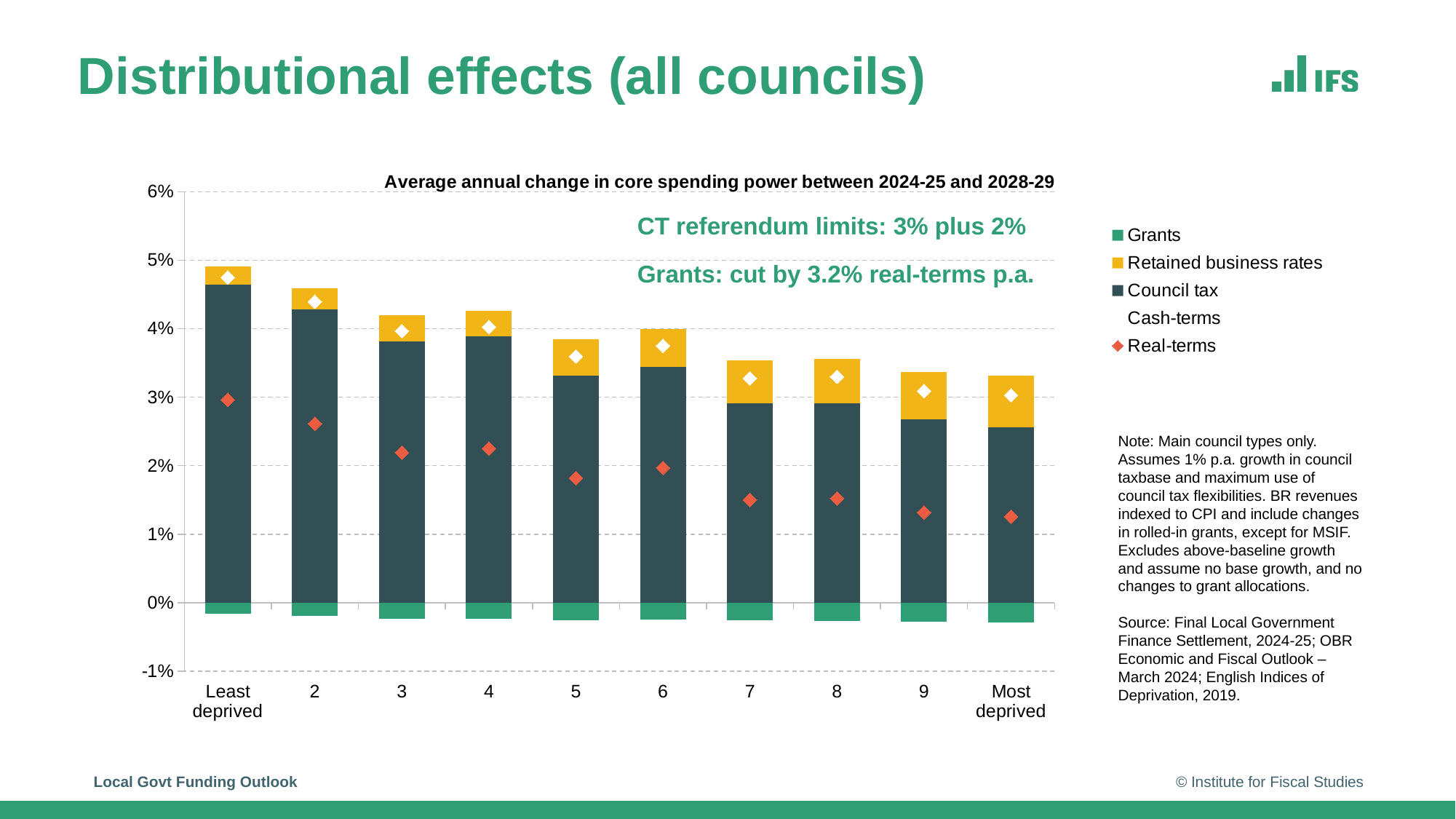
Is the Cash-terms value for category 5 greater or less than 4%? less How many deprivation categories are shown along the x axis? 10 Is the Real-terms value for category 7 greater or less than 1%? greater Is the Real-terms value for Most deprived greater or less than 2%? less How many series does the legend list? 5 Which category has the highest Cash-terms value? Least deprived Which is larger, the Real-terms value for category 2 or for category 3? category 2 What is the title of the chart? Average annual change in core spending power between 2024-25 and 2028-29 Do the Cash-terms values generally rise or fall moving from Least deprived to Most deprived? fall What kind of chart is shown on the slide? bar chart Which category has the highest Real-terms value? Least deprived